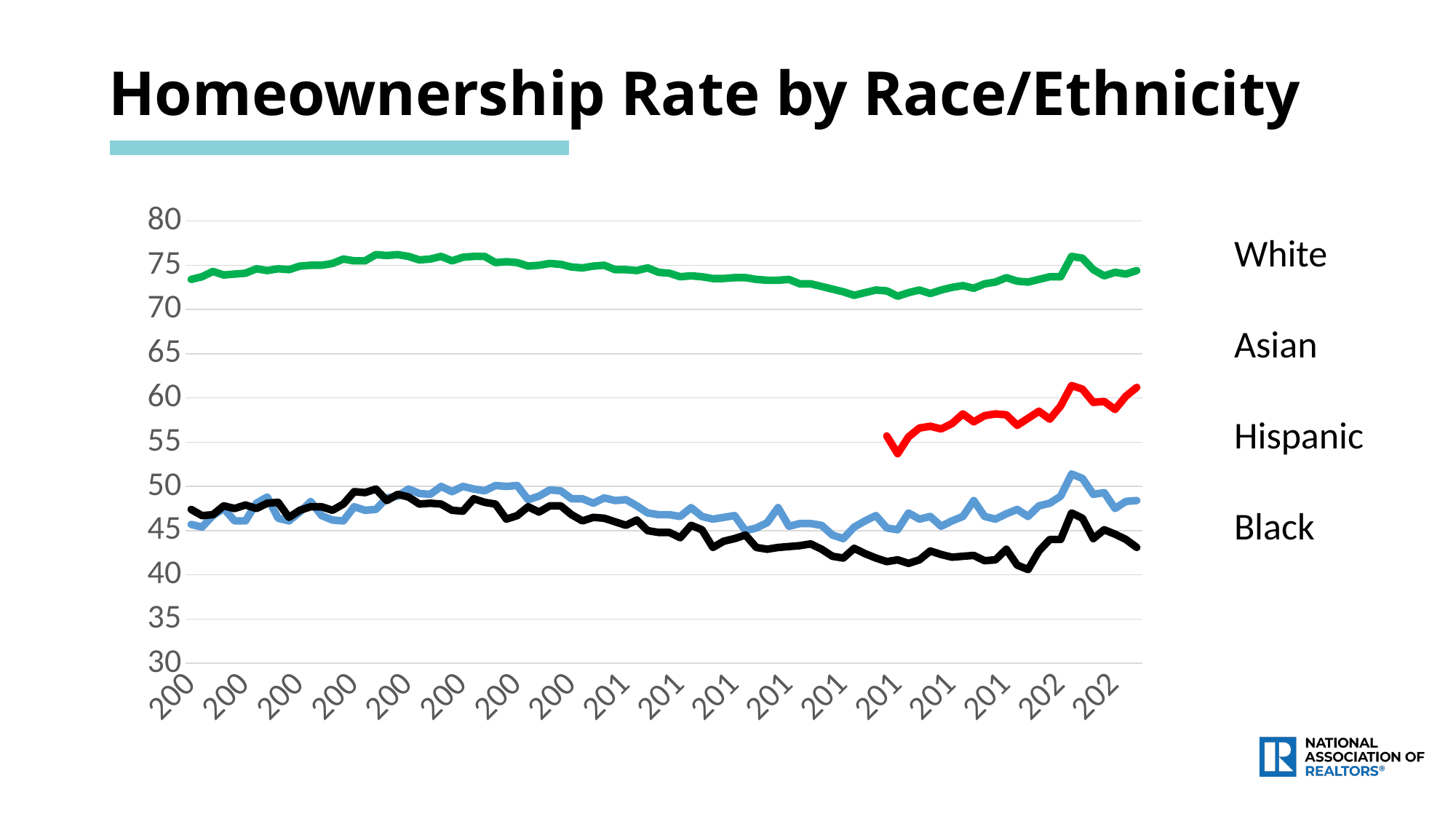
How many series does the chart show? 4 Is the value for Hispanic at the right end of the chart greater or less than 55? less Which series has the highest homeownership rate throughout the chart? White Is the value for Asian at the right end of the chart greater or less than 45? greater Is the lowest value for Black on the chart greater or less than 45? less What kind of chart is shown on the slide? line chart Which series has the lowest homeownership rate at the right end of the chart? Black At the right end of the chart, which is higher, Asian or Black? Asian Does the Hispanic series generally rise or fall from its start to its end? rise Which series starts latest on the x axis? Asian What is the title of the chart? Homeownership Rate by Race/Ethnicity